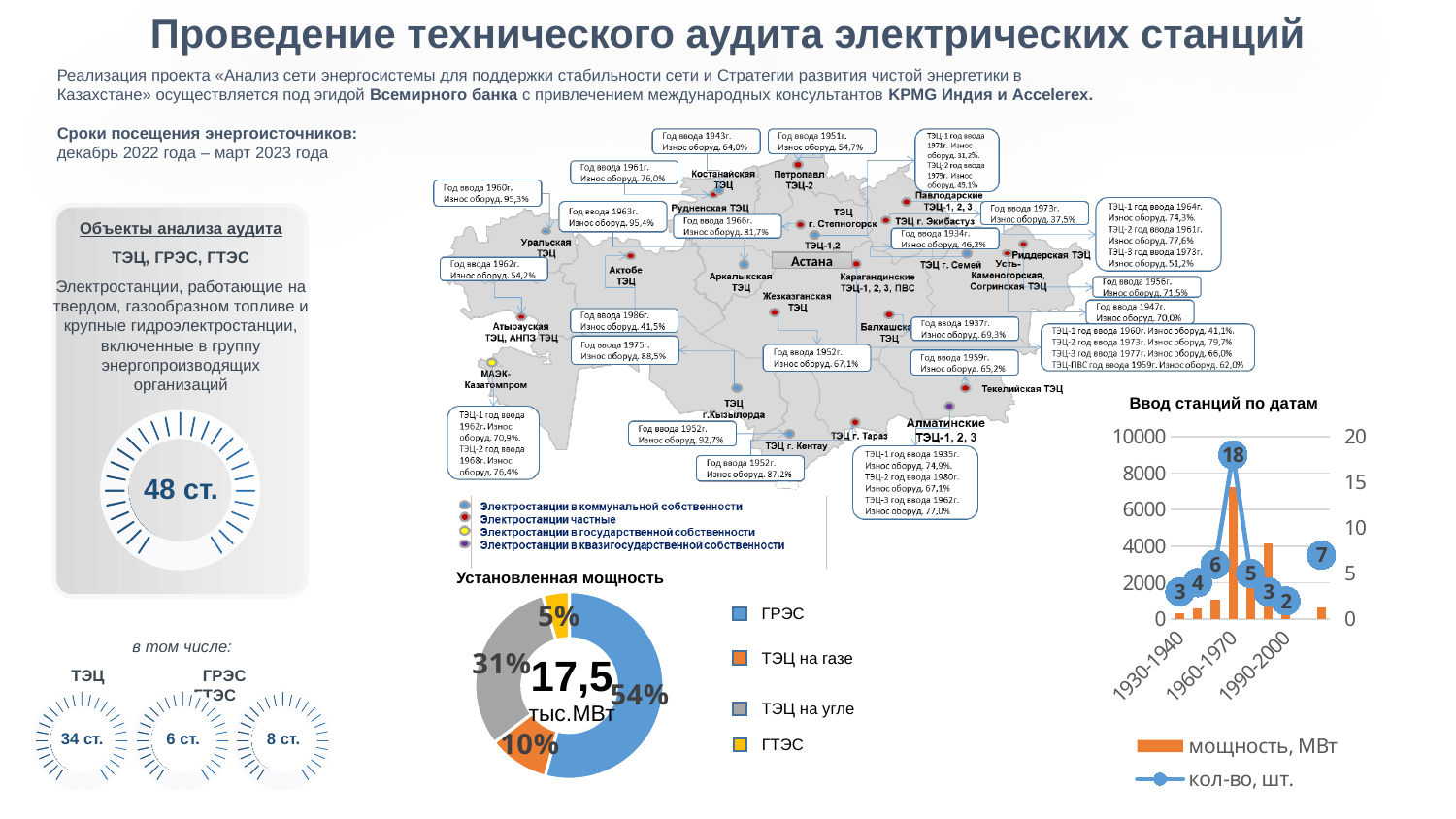
In the 'Установленная мощность' chart, which category has the smallest share? ГТЭС In the 'Установленная мощность' chart, which category has the largest share? ГРЭС What kind of chart is 'Установленная мощность'? pie (donut) chart In the 'Ввод станций по датам' chart, what is the highest value of кол-во, шт.? 18 In the 'Установленная мощность' chart, how many categories does the legend list? 4 In the 'Установленная мощность' chart, what share does ГТЭС have? 5% In the 'Ввод станций по датам' chart, how many series does the legend list? 2 In the 'Установленная мощность' chart, what total value is shown in the centre of the donut? 17,5 тыс.МВт In the 'Установленная мощность' chart, what is the difference in percentage points between ГРЭС and ТЭЦ на угле? 23 In the 'Ввод станций по датам' chart, what is the lowest labelled value of кол-во, шт.? 2 In the 'Установленная мощность' chart, what share does ТЭЦ на угле have? 31% In the 'Установленная мощность' chart, what share does ГРЭС have? 54%